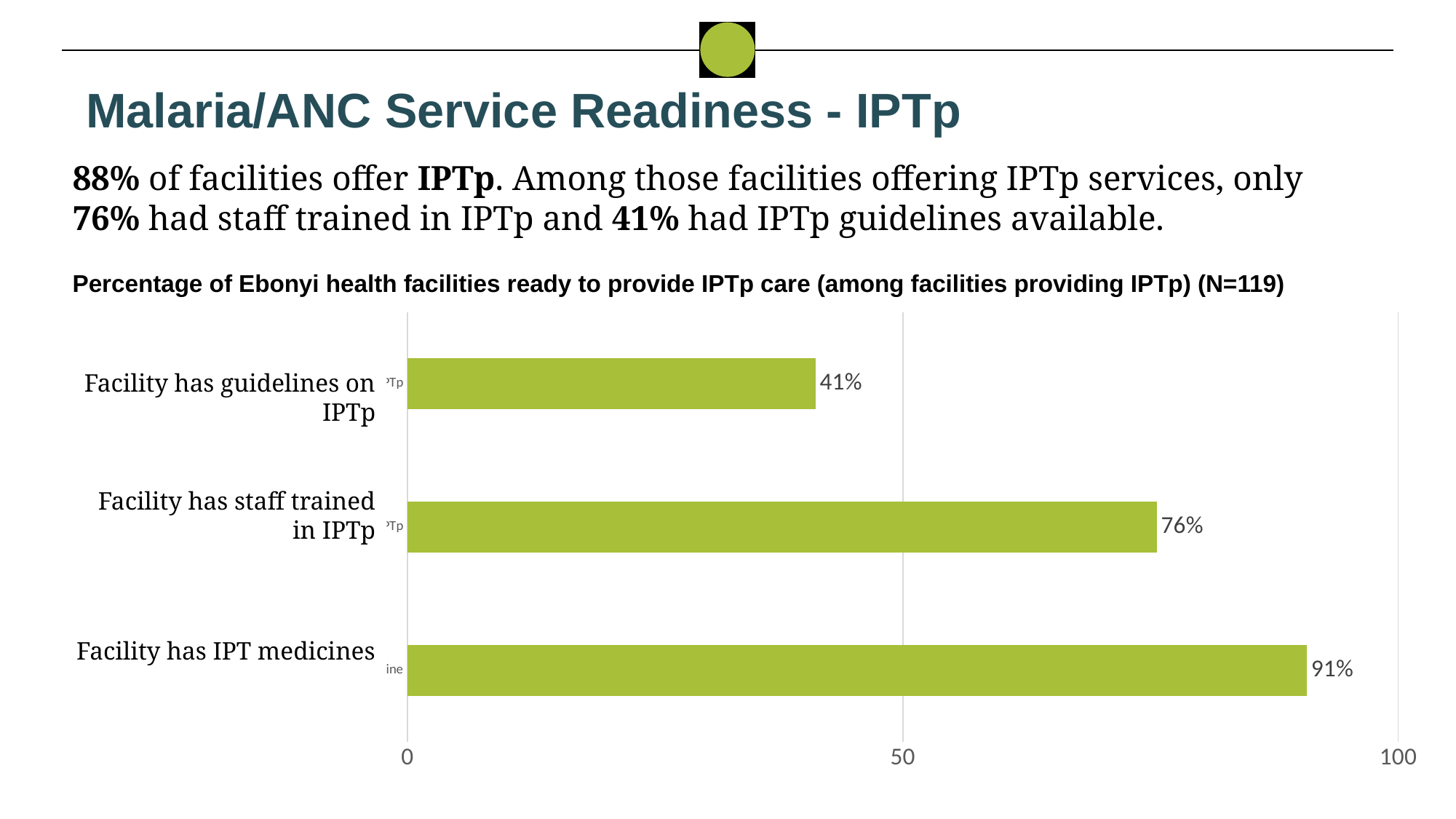
What is the difference between the percentage of facilities with staff trained in IPTp and those with guidelines on IPTp? 35% Is the value for facilities with guidelines on IPTp greater or less than 50? less What percentage of facilities have guidelines on IPTp? 41% What kind of chart is shown on the slide? Bar chart How many categories are shown in the chart? 3 What percentage of facilities have IPT medicines? 91% Which is larger: the value for facilities with staff trained in IPTp or facilities with IPT medicines? Facility has IPT medicines What percentage of facilities have staff trained in IPTp? 76% What is the difference between the percentage of facilities with IPT medicines and those with guidelines on IPTp? 50% Which category has the lowest value? Facility has guidelines on IPTp What is the sample size (N) stated in the chart title? 119 Which category has the highest value? Facility has IPT medicines